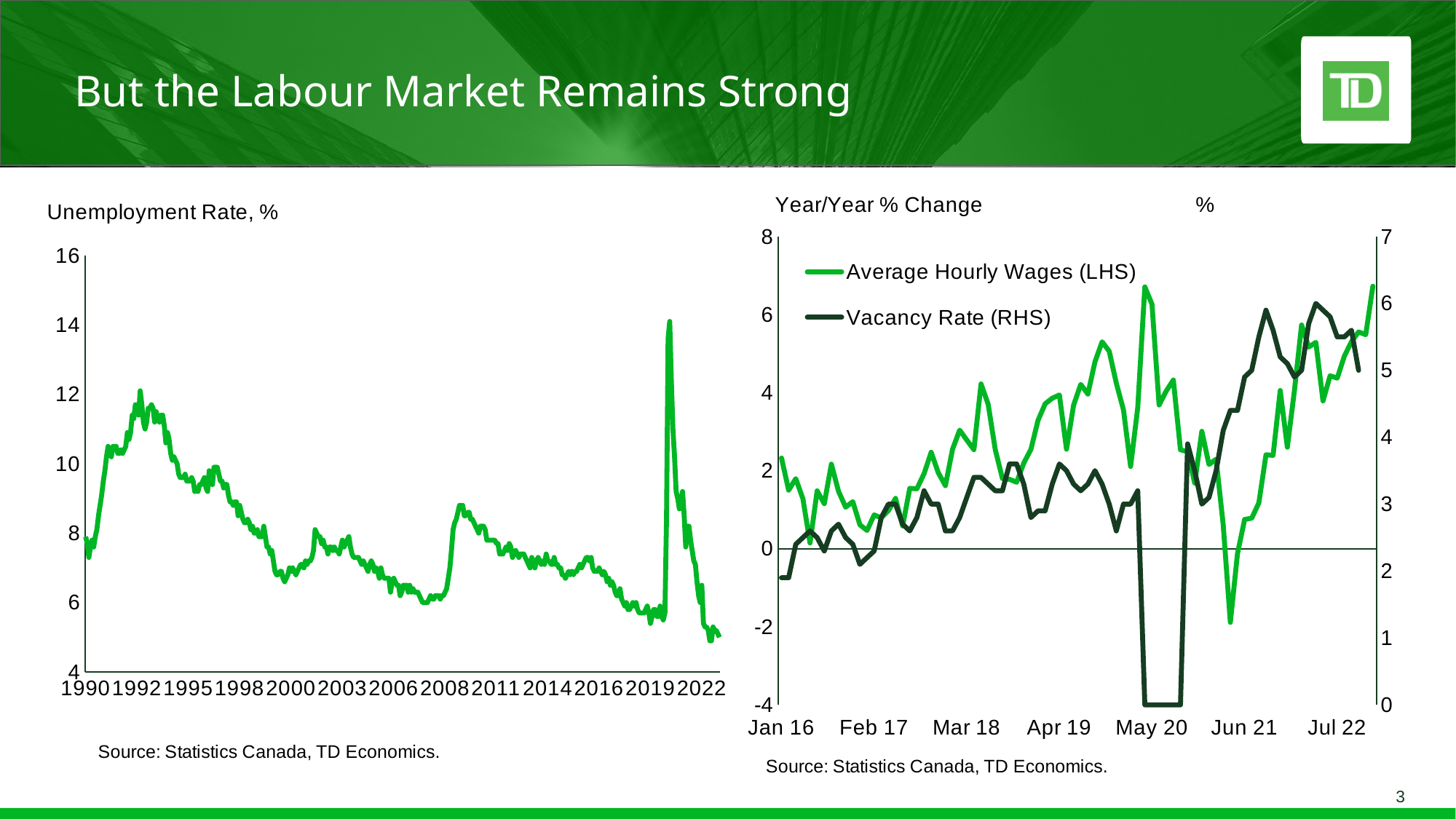
On the left chart, is the unemployment rate at its 2020 peak greater or less than 12? greater How many series does the legend of the right chart list? 2 On the left chart, is the unemployment rate at the end of the series in 2022 greater or less than 6? less On the left chart, does the unemployment rate overall rise or fall from 1990 to 2022? fall What is the axis label shown above the left chart? Unemployment Rate, % On the left chart, is the unemployment rate around 1992 greater or less than 10? greater On the right chart, which series is plotted on the right-hand axis (RHS)? Vacancy Rate What kind of chart is the left chart showing the unemployment rate? line chart